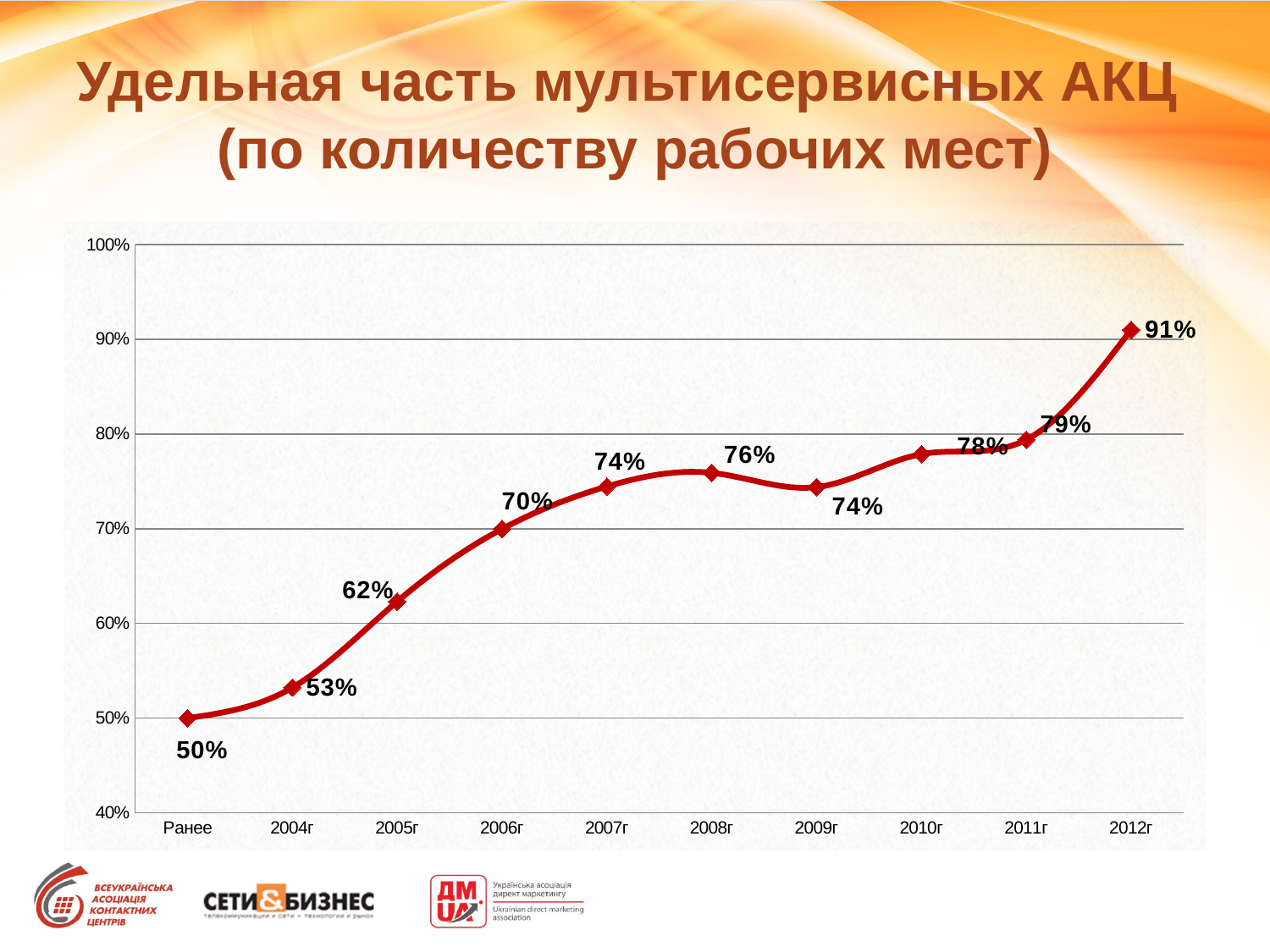
What is the value for Ранее? 50% What is the value for 2008г? 76% Which is larger, the value for 2008г or the value for 2009г? 2008г What is the value for 2012г? 91% What kind of chart is shown on the slide? line chart Which category has the lowest value? Ранее Which category has the highest value? 2012г Do the values generally rise or fall from Ранее to 2012г? rise What is the title of the chart? Удельная часть мультисервисных АКЦ (по количеству рабочих мест) What is the difference between the values for 2012г and 2011г? 12% How many data points are plotted on the chart? 10 What is the value for 2005г? 62%